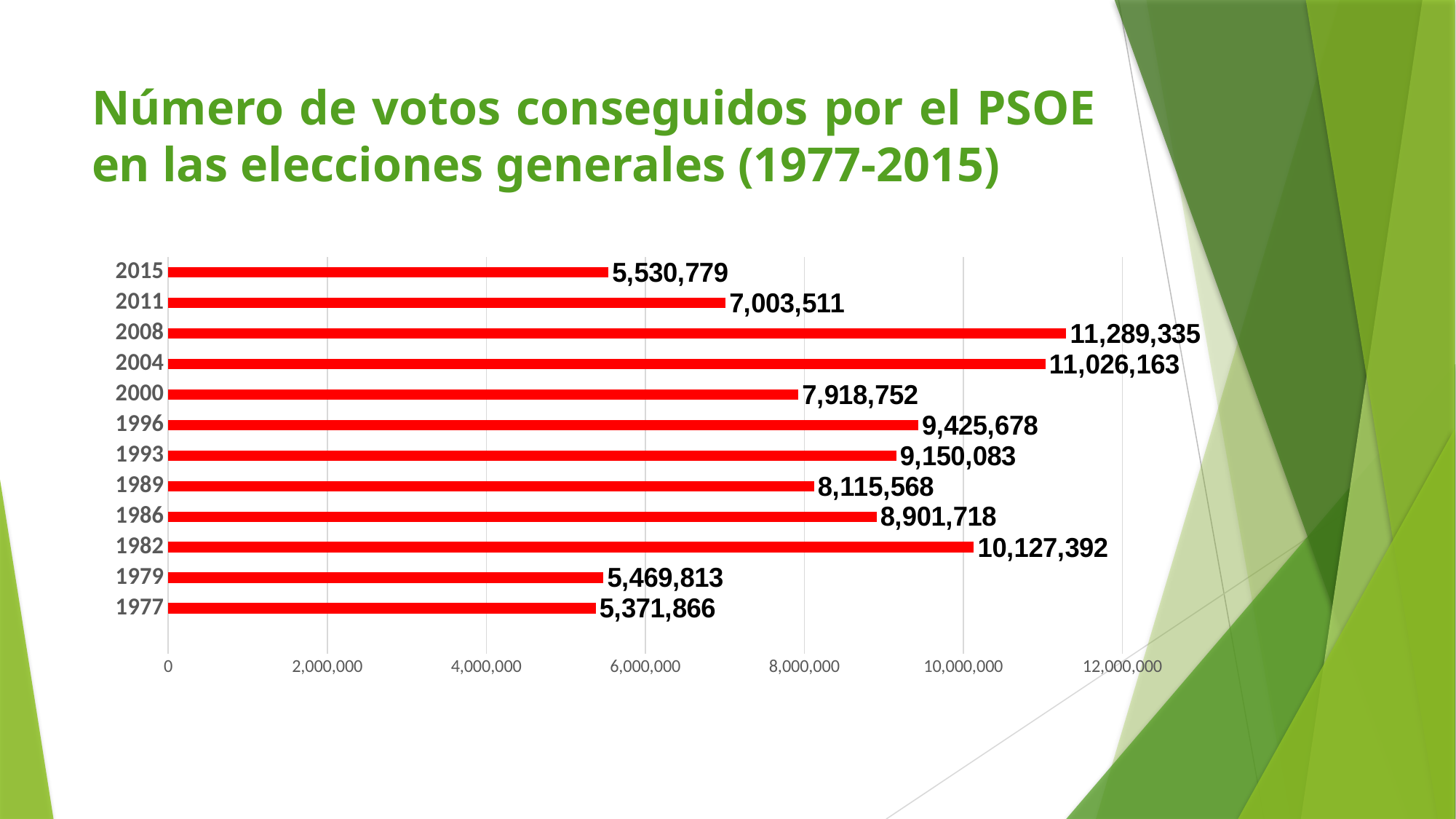
Is the value for 2000 greater or less than 8,000,000? less What kind of chart is shown on the slide? bar chart Which year had more votes, 1996 or 1993? 1996 What colour are the bars in the chart? red What is the difference between the votes in 2008 and 2004? 263,172 What is the value shown for 1977? 5,371,866 How many votes did the PSOE obtain in 2008? 11,289,335 Which year has the highest number of votes? 2008 Which year has the lowest number of votes? 1977 What is the value shown for 1982? 10,127,392 What is the difference between the votes in 2011 and 2015? 1,472,732 How many election years are shown in the chart? 12